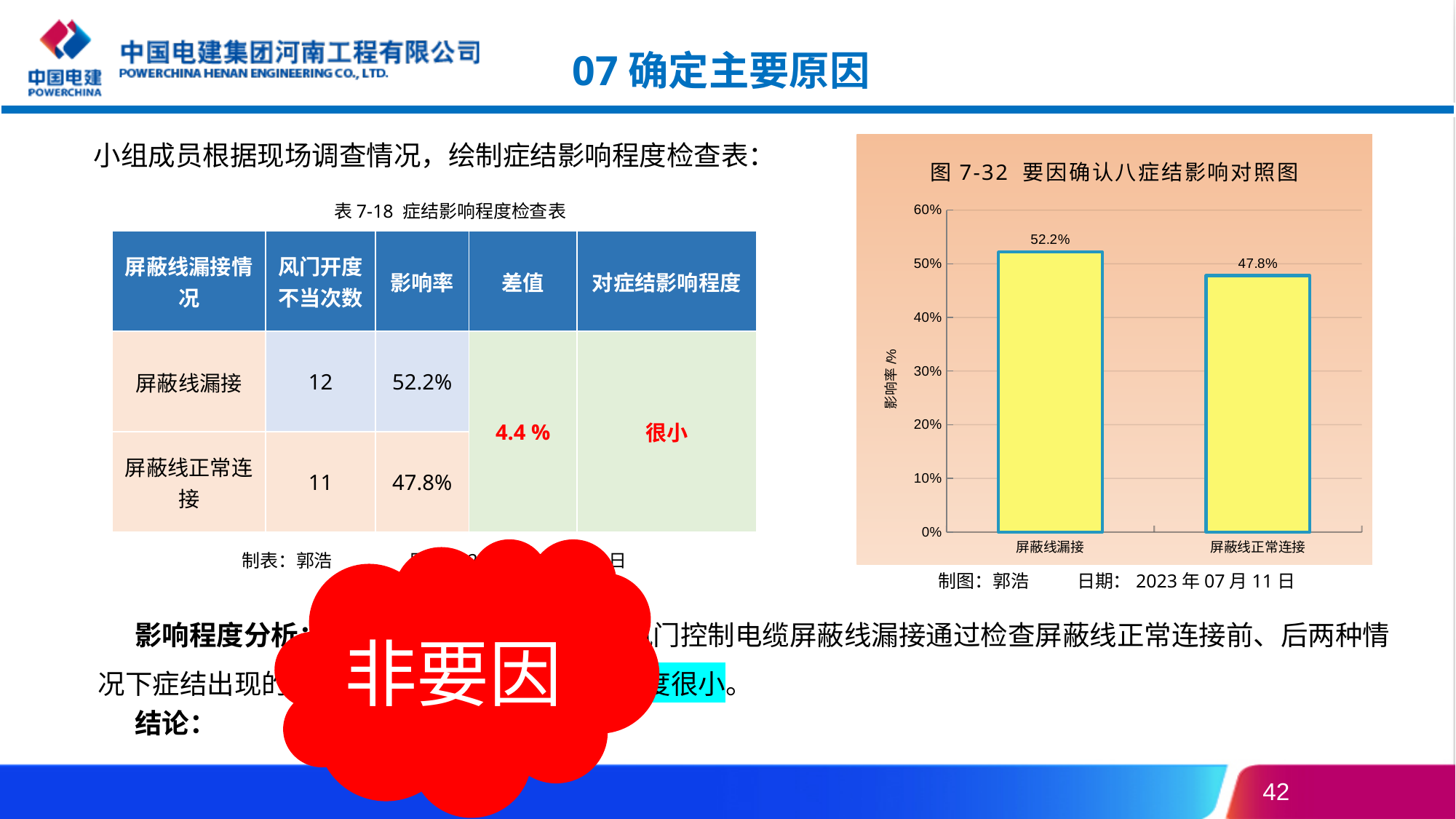
What kind of chart is shown on the slide? bar chart What is the value for 屏蔽线漏接 in the chart? 52.2% What is the label of the y axis of the chart? 影响率 /% Which is larger in the chart, the value for 屏蔽线漏接 or the value for 屏蔽线正常连接? 屏蔽线漏接 Is the value for 屏蔽线漏接 in the chart greater or less than 40%? greater How many categories are shown in the chart? 2 Is the value for 屏蔽线正常连接 in the chart greater or less than 50%? less What is the value for 屏蔽线正常连接 in the chart? 47.8% What is the difference between the values for 屏蔽线漏接 and 屏蔽线正常连接 in the chart? 4.4% What is the title of the chart? 图 7-32 要因确认八症结影响对照图 Which category has the lowest value in the chart? 屏蔽线正常连接 Which category has the highest value in the chart? 屏蔽线漏接